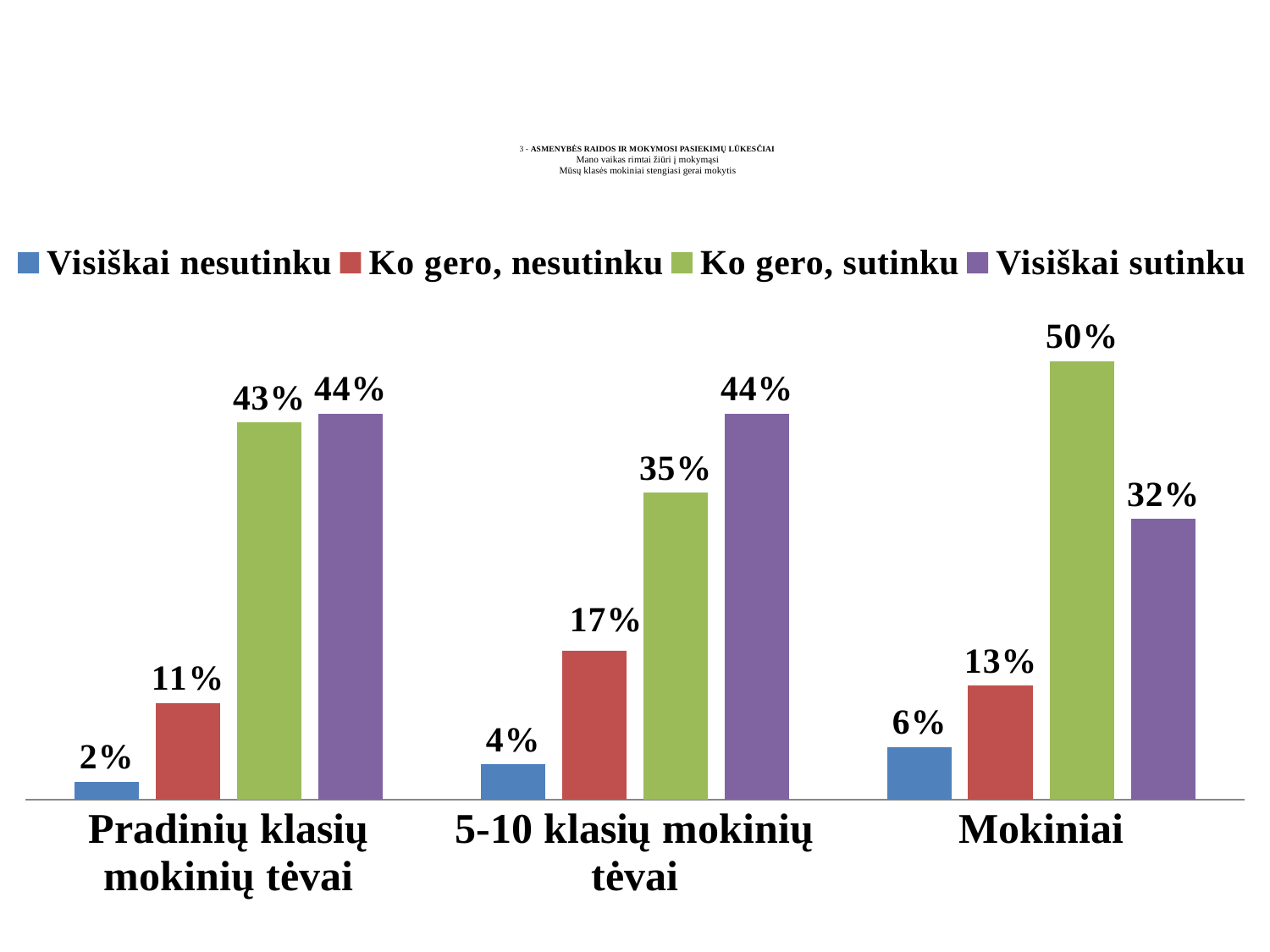
Which category has the highest value for "Visiškai nesutinku"? Mokiniai What is the difference between "Ko gero, nesutinku" for "5-10 klasių mokinių tėvai" and for "Pradinių klasių mokinių tėvai"? 6% What is the value for "Visiškai nesutinku" in the "Pradinių klasių mokinių tėvai" category? 2% What is the difference between "Ko gero, sutinku" and "Visiškai sutinku" in the "Mokiniai" category? 18% What is the value for "Ko gero, nesutinku" in the "5-10 klasių mokinių tėvai" category? 17% Which colour represents the "Ko gero, sutinku" series? Green How many categories are shown on the x axis? 3 How many series does the legend list? 4 Which category has the lowest value for "Visiškai sutinku"? Mokiniai What is the value for "Ko gero, sutinku" in the "Mokiniai" category? 50% What kind of chart is shown on the slide? Bar chart Which is larger in the "5-10 klasių mokinių tėvai" category: "Ko gero, sutinku" or "Visiškai sutinku"? Visiškai sutinku